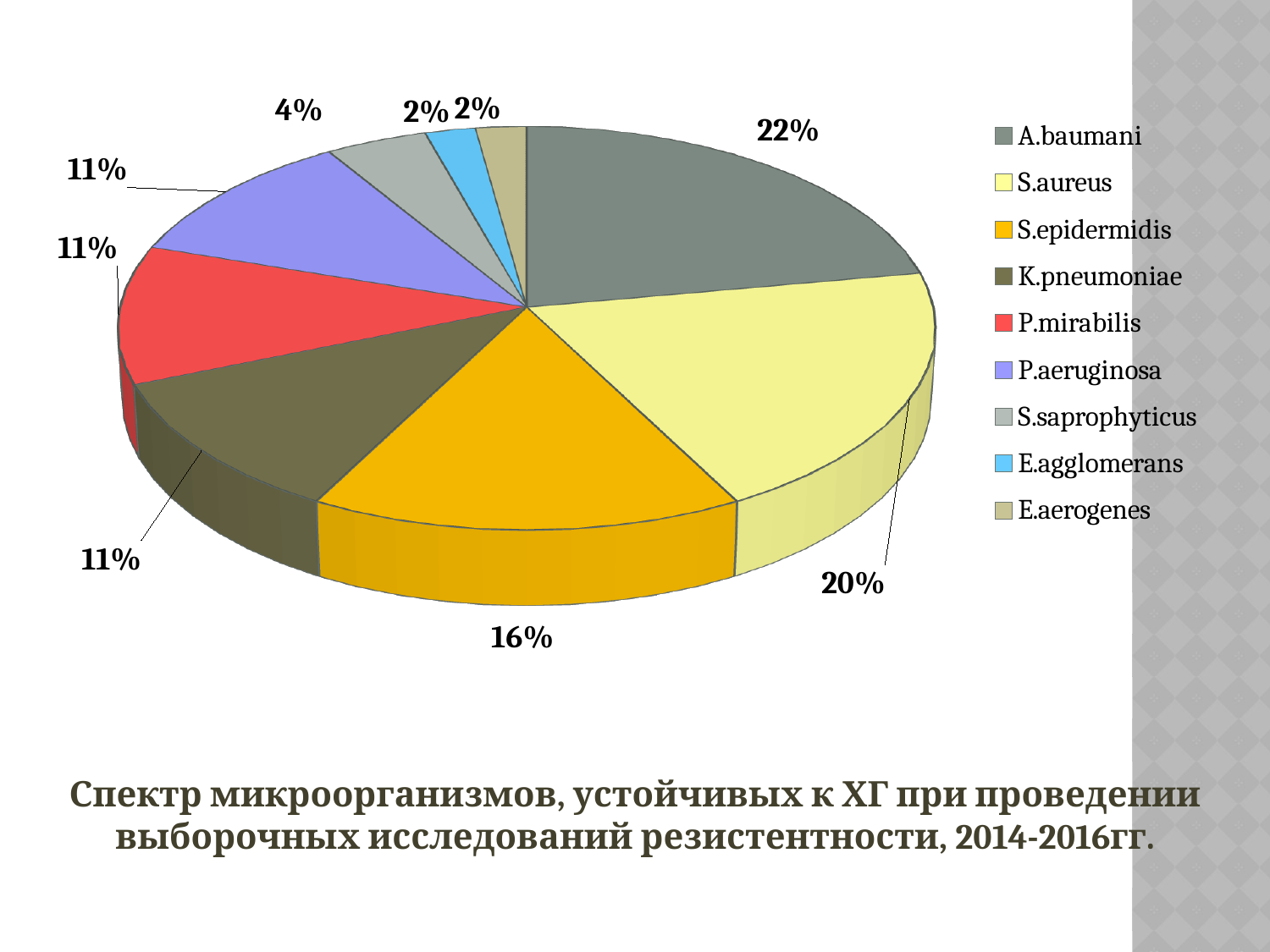
Which microorganism is shown in red in the pie chart? P.mirabilis What share of the pie does S.aureus account for? 20% What share of the pie does E.agglomerans account for? 2% Which microorganism has the largest slice of the pie? A.baumani What share of the pie does A.baumani account for? 22% What kind of chart is shown on the slide? pie chart How many slices does the pie chart have? 9 Which is larger, the share for S.aureus or the share for S.epidermidis? S.aureus What is the difference in percentage points between the shares of A.baumani and S.aureus? 2